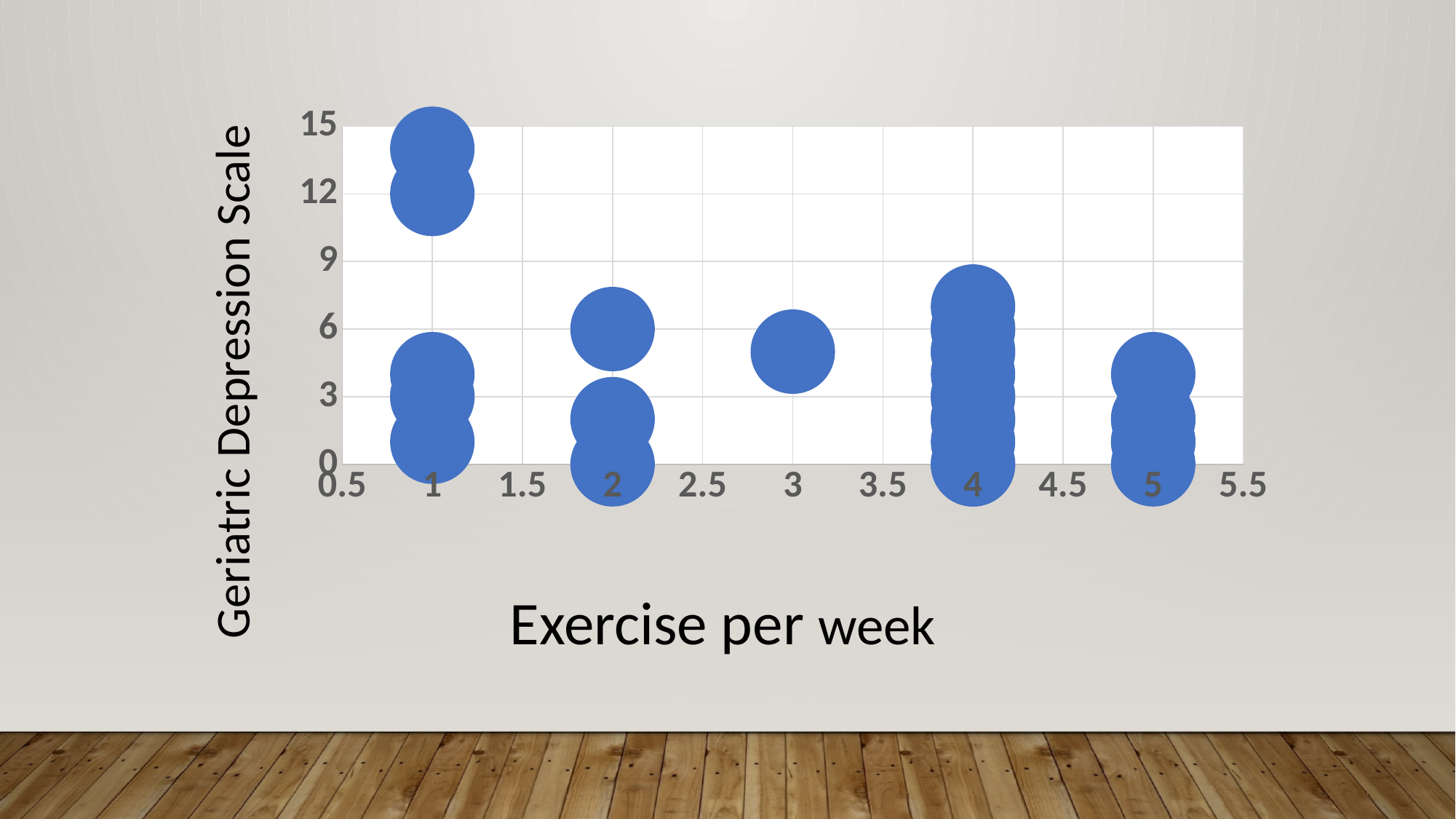
Is the highest Geriatric Depression Scale value at 4 exercises per week greater or less than 9? less At which exercise-per-week value does the highest Geriatric Depression Scale point appear? 1 What is the title of the y axis? Geriatric Depression Scale Which has a higher maximum Geriatric Depression Scale value: 1 exercise per week or 5 exercises per week? 1 exercise per week Is the highest Geriatric Depression Scale value at 1 exercise per week greater or less than 12? greater What is the highest value shown on the y axis? 15 Is the highest Geriatric Depression Scale value at 5 exercises per week greater or less than 6? less How many distinct exercise-per-week values have data points plotted? 5 What is the title of the x axis? Exercise per week What kind of chart is shown on the slide? bubble chart